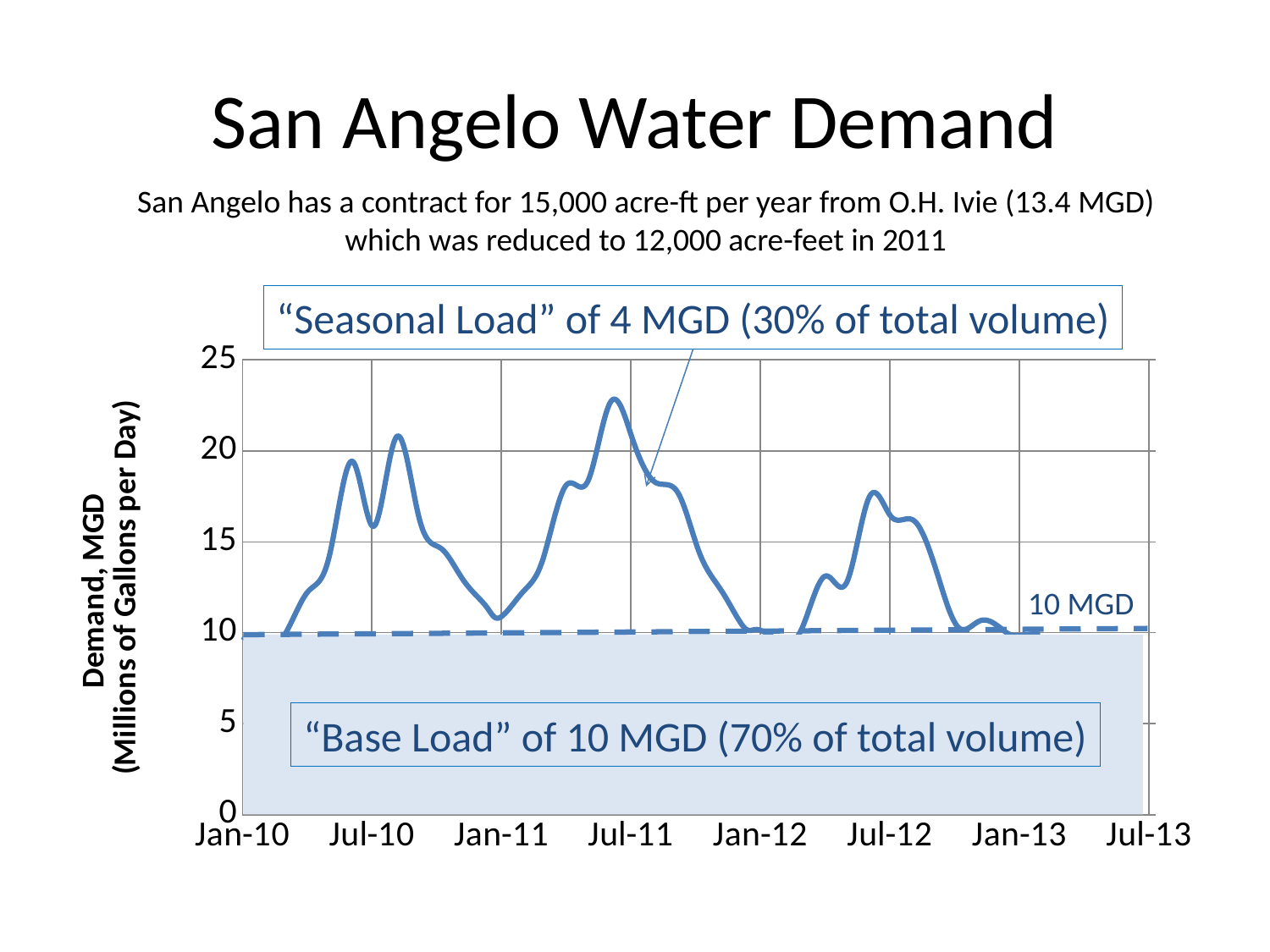
What is the title of the chart on the slide? San Angelo Water Demand Is the peak demand in mid-2011 greater or less than 20 MGD? greater How many tick labels are shown on the horizontal axis? 8 Which summer had the higher peak demand, 2011 or 2012? 2011 What kind of chart is shown on the slide? line chart In which year does the demand line reach its highest peak? 2011 Is the peak demand in mid-2012 greater or less than 20 MGD? less Is the demand at Jul-12 greater or less than 15 MGD? greater What is the label on the vertical axis of the chart? Demand, MGD (Millions of Gallons per Day) What value does the dashed horizontal line on the chart represent? 10 MGD Does demand rise or fall between Jul-11 and Jan-12? fall